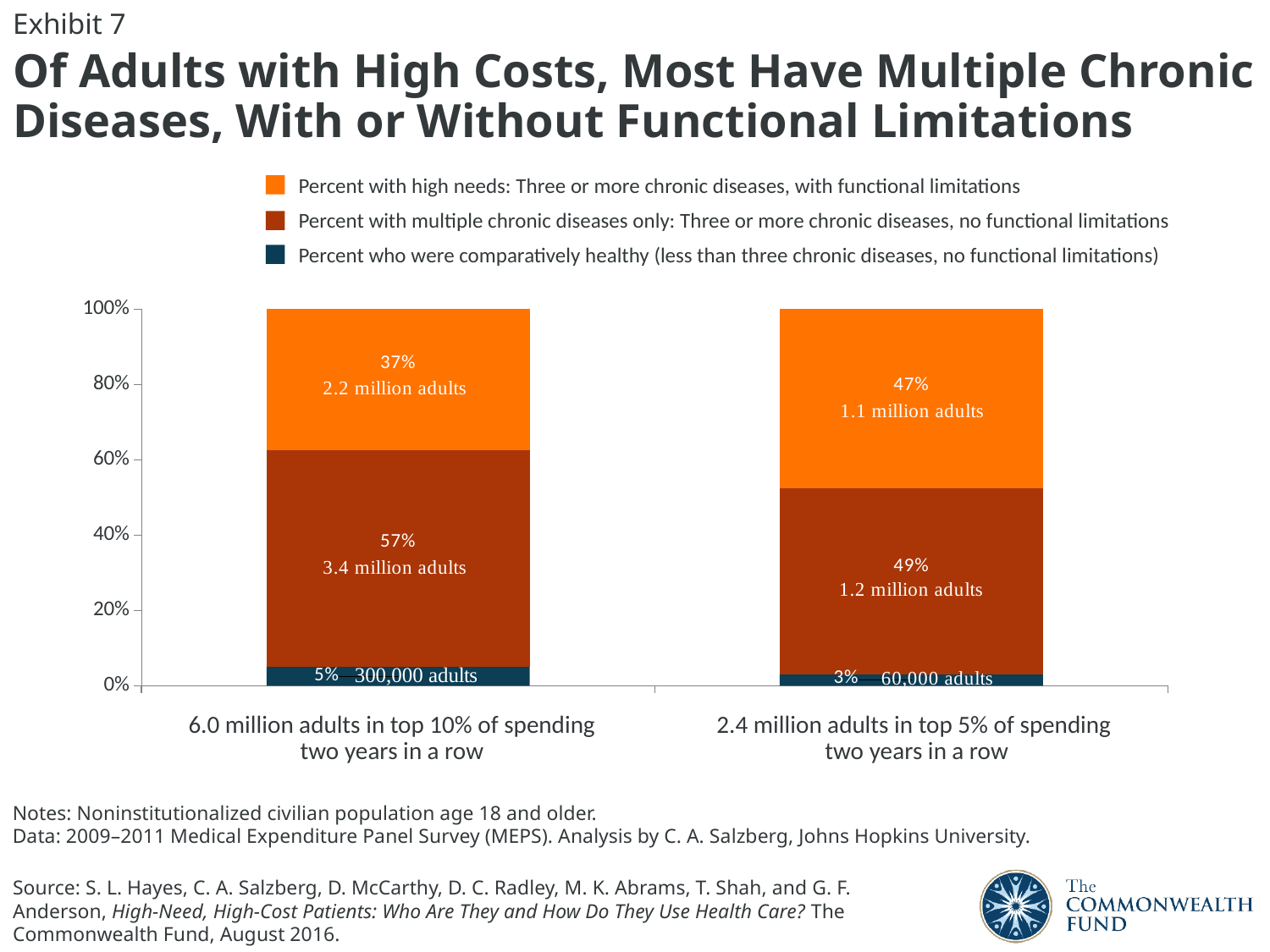
What is the total of the three percentages in the bar for adults in the top 5% of spending two years in a row? 99% How many adults in the top 10% of spending two years in a row were comparatively healthy? 300,000 adults Which segment is the largest in the bar for adults in the top 10% of spending two years in a row? Percent with multiple chronic diseases only What percentage of adults in the top 10% of spending two years in a row had high needs (three or more chronic diseases, with functional limitations)? 37% How many series does the legend list? 3 What is the difference in the percentage with high needs between the top 5% of spending group and the top 10% of spending group? 10 percentage points What kind of chart is shown on the slide? Stacked bar chart Which segment is the smallest in the bar for adults in the top 5% of spending two years in a row? Percent who were comparatively healthy How many adults in the top 5% of spending two years in a row had high needs? 1.1 million adults Which group has a larger percentage of comparatively healthy adults: the top 10% of spending group or the top 5% of spending group? The top 10% of spending group How many bars are shown in the chart? 2 What percentage of adults in the top 5% of spending two years in a row had multiple chronic diseases only? 49%